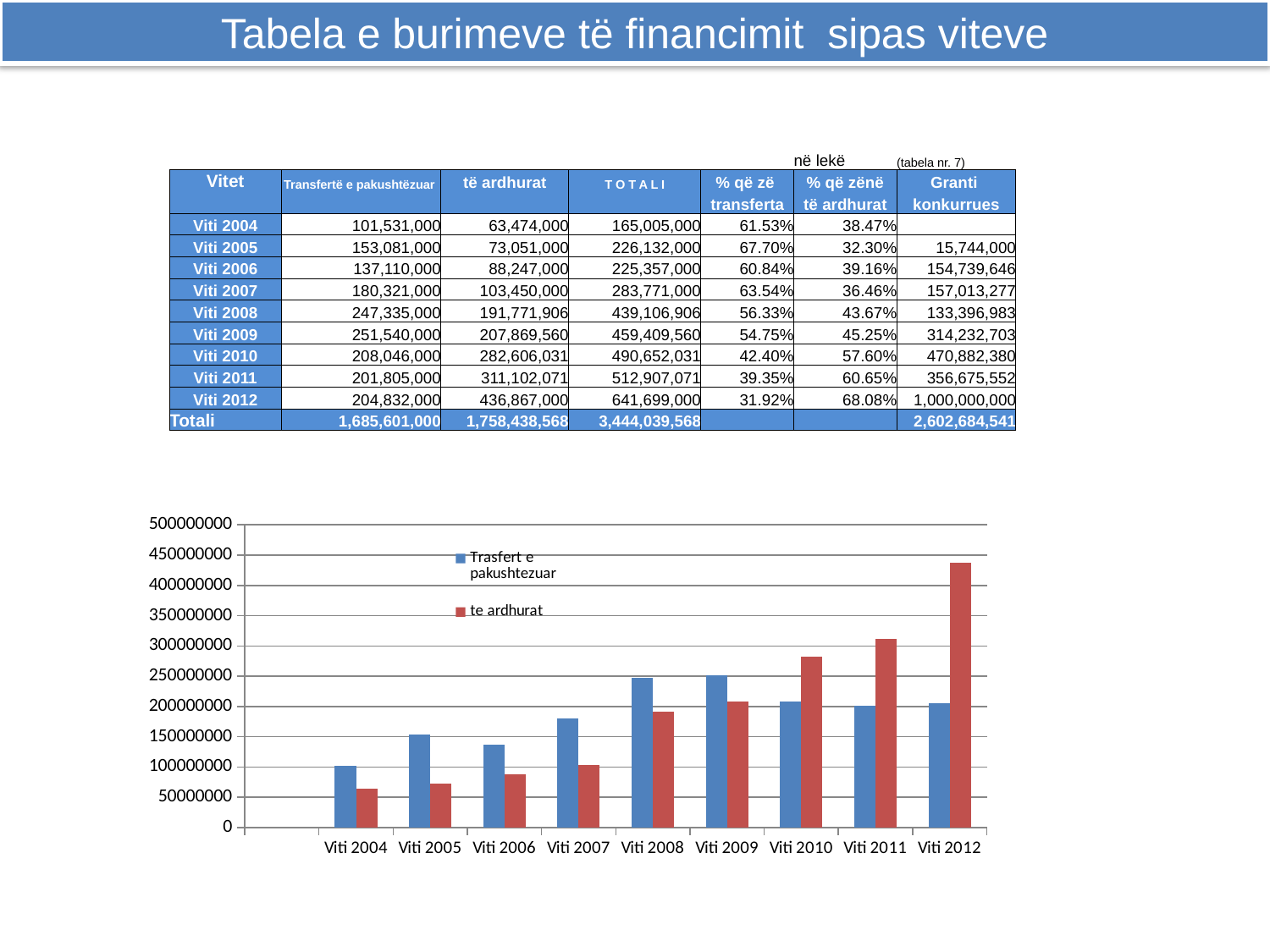
Is the 'te ardhurat' value for Viti 2012 greater or less than 400000000? greater How many series does the chart's legend list? 2 What kind of chart is shown at the bottom of the slide? bar chart In the chart, which year has the lowest 'Trasfert e pakushtezuar' bar? Viti 2004 In the chart, which year has the highest 'te ardhurat' bar? Viti 2012 For Viti 2011, which is larger in the chart: 'Trasfert e pakushtezuar' or 'te ardhurat'? te ardhurat Do the 'te ardhurat' bars generally rise or fall from Viti 2004 to Viti 2012? rise For Viti 2008, which is larger in the chart: 'Trasfert e pakushtezuar' or 'te ardhurat'? Trasfert e pakushtezuar What colour are the 'te ardhurat' bars in the chart? red According to the table, what is the 'të ardhurat' value for Viti 2010? 282,606,031 Is the 'Trasfert e pakushtezuar' value for Viti 2006 greater or less than 150000000? less How many years are shown along the x axis of the chart? 9